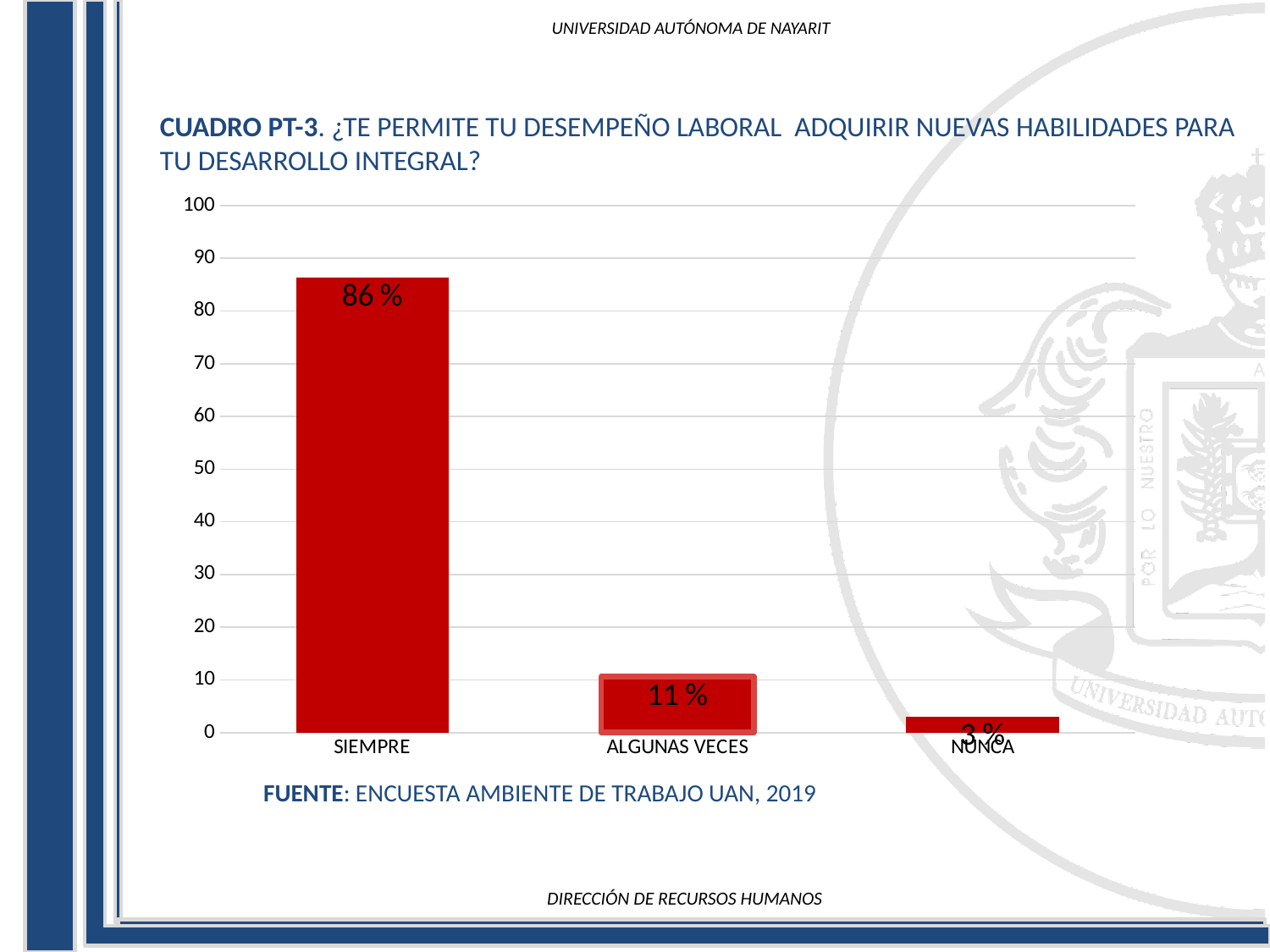
Which category has the lowest value? NUNCA What is the value for ALGUNAS VECES? 11 % What is the value for NUNCA? 3 % What is the difference between the values for ALGUNAS VECES and NUNCA? 8 % Which category has the highest value? SIEMPRE What kind of chart is shown on the slide? bar chart How many categories are shown on the x axis? 3 Which is larger, the value for ALGUNAS VECES or the value for NUNCA? ALGUNAS VECES What is the difference between the values for SIEMPRE and ALGUNAS VECES? 75 % What source is cited below the chart? ENCUESTA AMBIENTE DE TRABAJO UAN, 2019 What is the value for SIEMPRE? 86 % Is the value for SIEMPRE greater or less than 80? greater